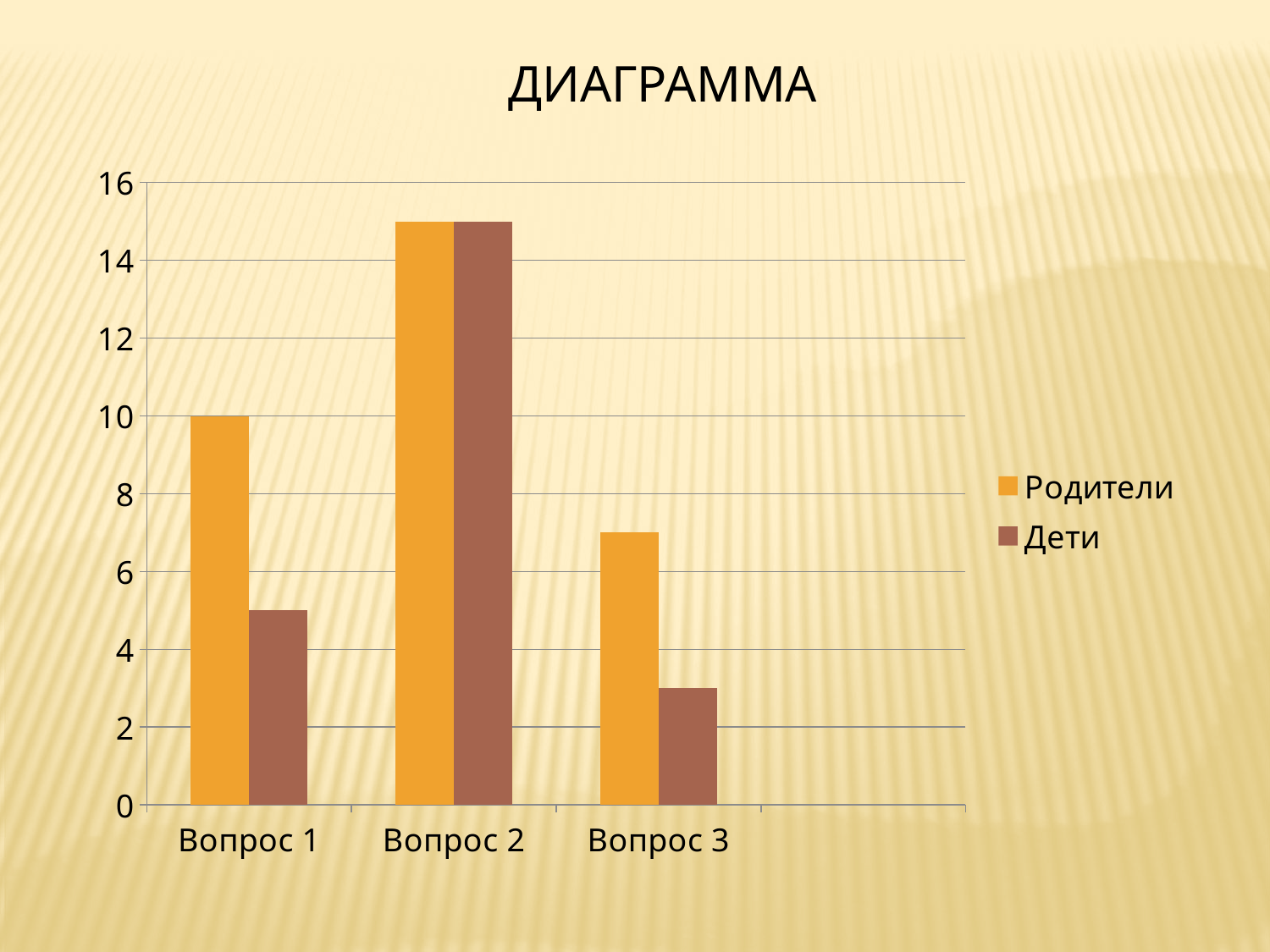
How many categories are shown on the x axis? 3 For Вопрос 1, which series has the larger value, Родители or Дети? Родители For which category is the Дети value lowest? Вопрос 3 How many series does the legend list? 2 Is the value for Родители for Вопрос 3 greater or less than 6? greater Is the value for Дети for Вопрос 1 greater or less than 6? less Is the value for Дети for Вопрос 3 greater or less than 4? less What kind of chart is shown on the slide? bar chart What is the title of the slide? ДИАГРАММА For which category is the Родители value highest? Вопрос 2 What is the value for Родители for Вопрос 1? 10